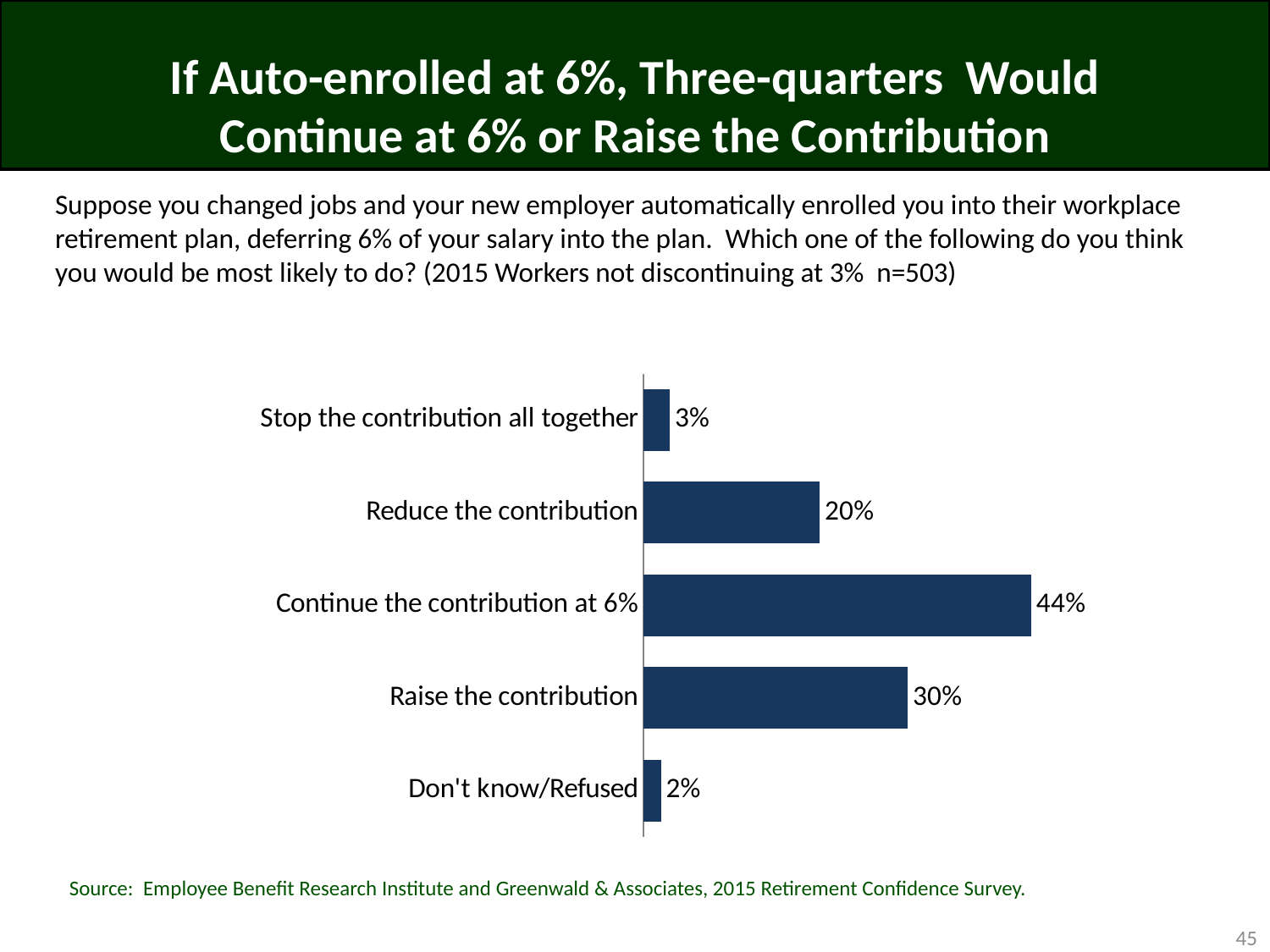
What type of chart is shown on the slide? Bar chart What percentage of workers would stop the contribution all together? 3% How many response categories are shown in the chart? 5 What is the difference between the percentage who would continue the contribution at 6% and the percentage who would raise the contribution? 14% What percentage of workers would continue the contribution at 6%? 44% Which response has the highest percentage? Continue the contribution at 6% Which is larger: the percentage who would reduce the contribution or the percentage who would raise the contribution? Raise the contribution Which response has the lowest percentage? Don't know/Refused What percentage of workers would raise the contribution? 30% What is the combined percentage of workers who would continue the contribution at 6% or raise the contribution? 74% What is the value for Don't know/Refused? 2% What percentage of workers would reduce the contribution? 20%